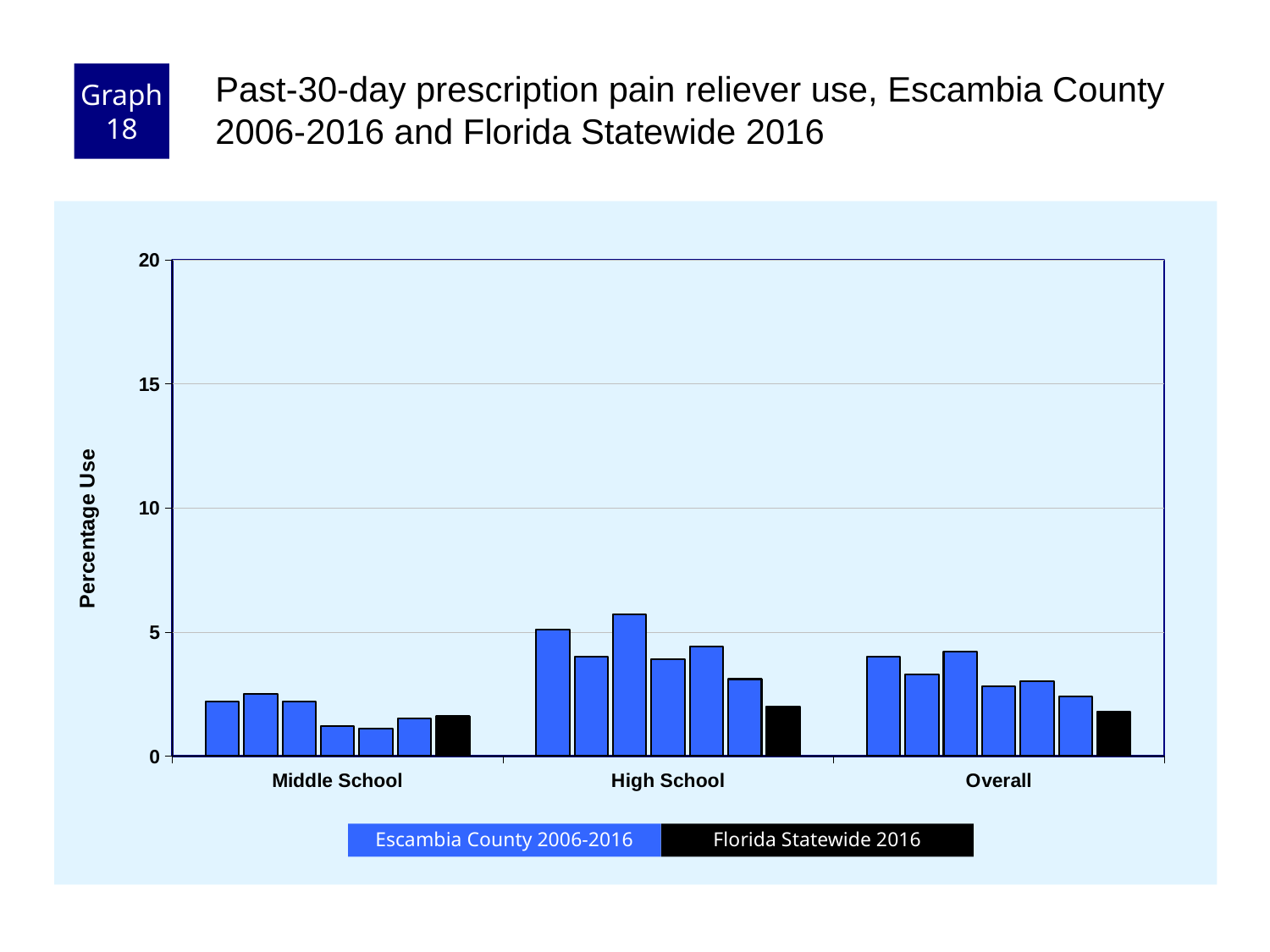
What colour represents Florida Statewide 2016 in the legend? black What is the label on the y axis? Percentage Use How many categories are shown on the x axis? 3 Is the Florida Statewide 2016 value for High School greater or less than 5? less Is the Florida Statewide 2016 value for Middle School greater or less than 5? less How many series does the legend list? 2 Which is larger, the Florida Statewide 2016 value for High School or for Middle School? High School Is any bar on the chart greater than 10? No Which category has the highest bars overall? High School Which category has the lowest bars overall? Middle School What kind of chart is shown on the slide? bar chart